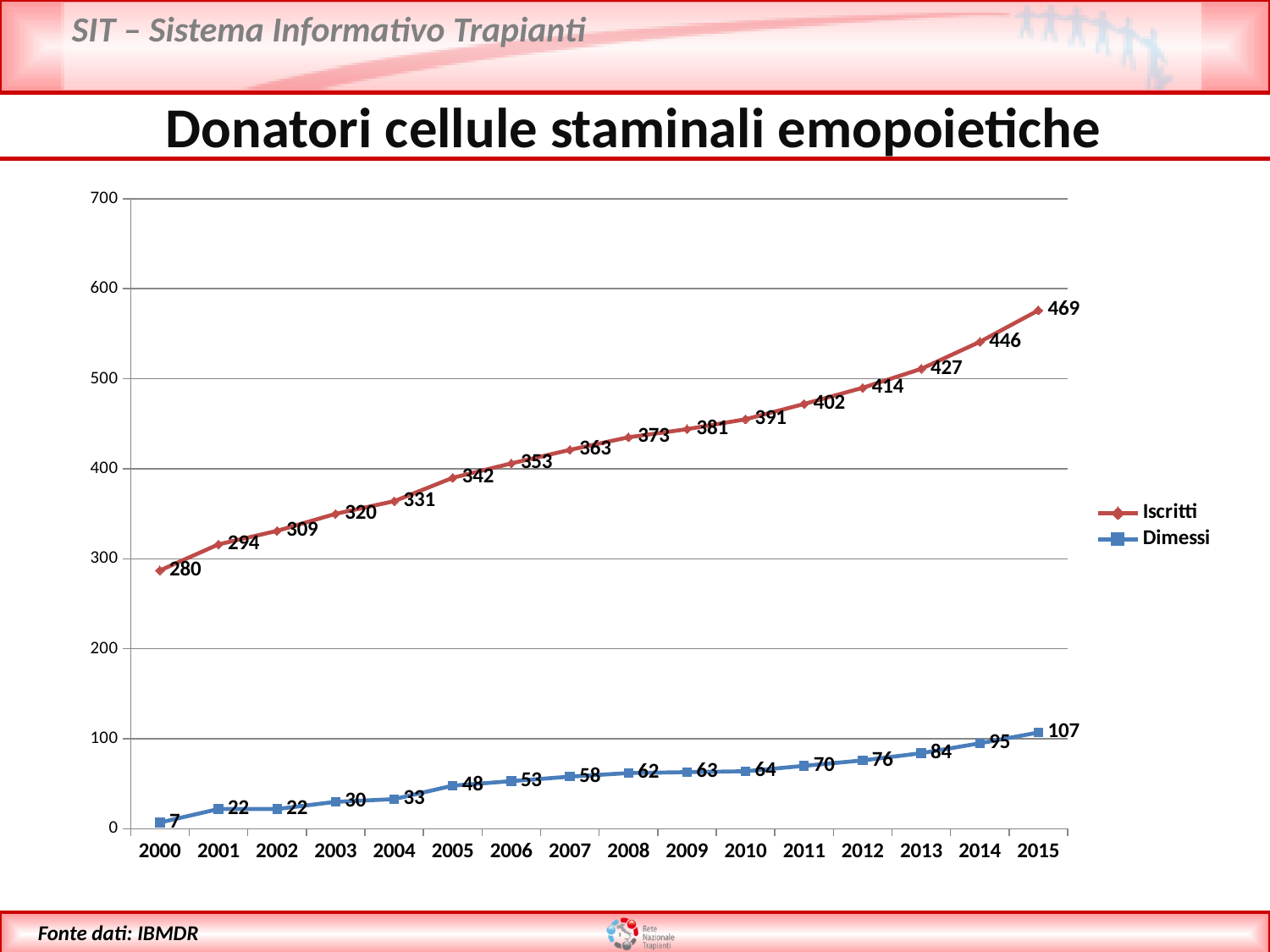
What type of chart is shown on the slide? line chart What is the difference between Iscritti and Dimessi in 2015? 362 Which is larger, the Dimessi value in 2005 or in 2004? 2005 How many series does the legend list? 2 In which year is the Iscritti value lowest? 2000 What is the value of Dimessi in 2000? 7 In which year is the Dimessi value highest? 2015 How many years are shown on the x axis? 16 Do the Iscritti values rise or fall from 2000 to 2015? rise What is the value of Dimessi in 2013? 84 What is the value of Iscritti in 2008? 373 What is the value of Iscritti in 2015? 469